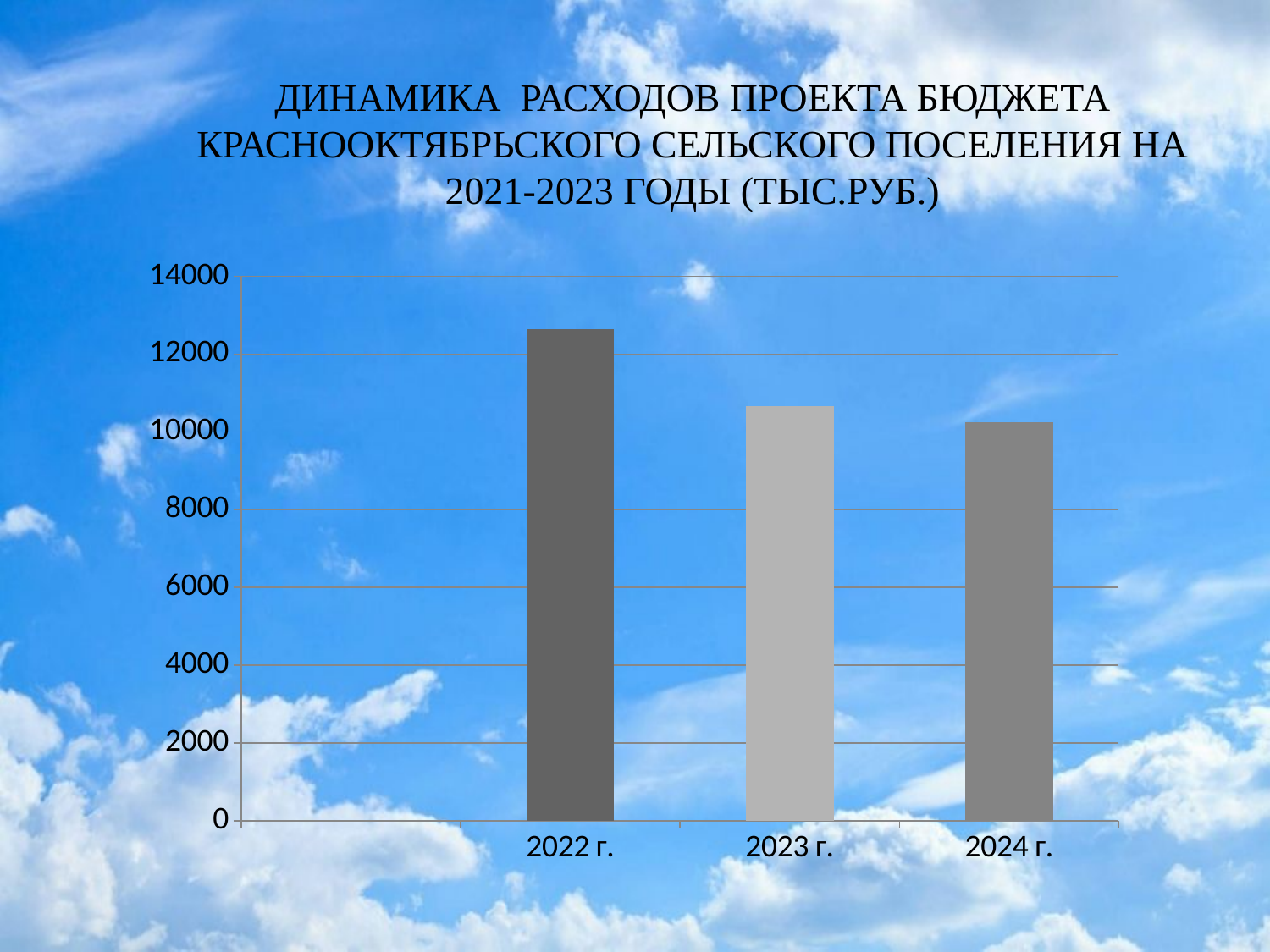
Is the value for 2024 г. greater or less than 12000? less Which year has the lowest value in the chart? 2024 г. Which year has the highest value in the chart? 2022 г. Is the value for 2023 г. greater or less than 10000? greater Do the values rise or fall from 2022 г. to 2024 г.? fall How many bars (years) are plotted in the chart? 3 Is the value for 2022 г. greater or less than 12000? greater Which is larger, the value for 2022 г. or the value for 2023 г.? 2022 г. Which is larger, the value for 2022 г. or the value for 2024 г.? 2022 г. In what units are the values in the chart expressed, according to the slide title? тыс.руб. What kind of chart is shown on the slide? bar chart